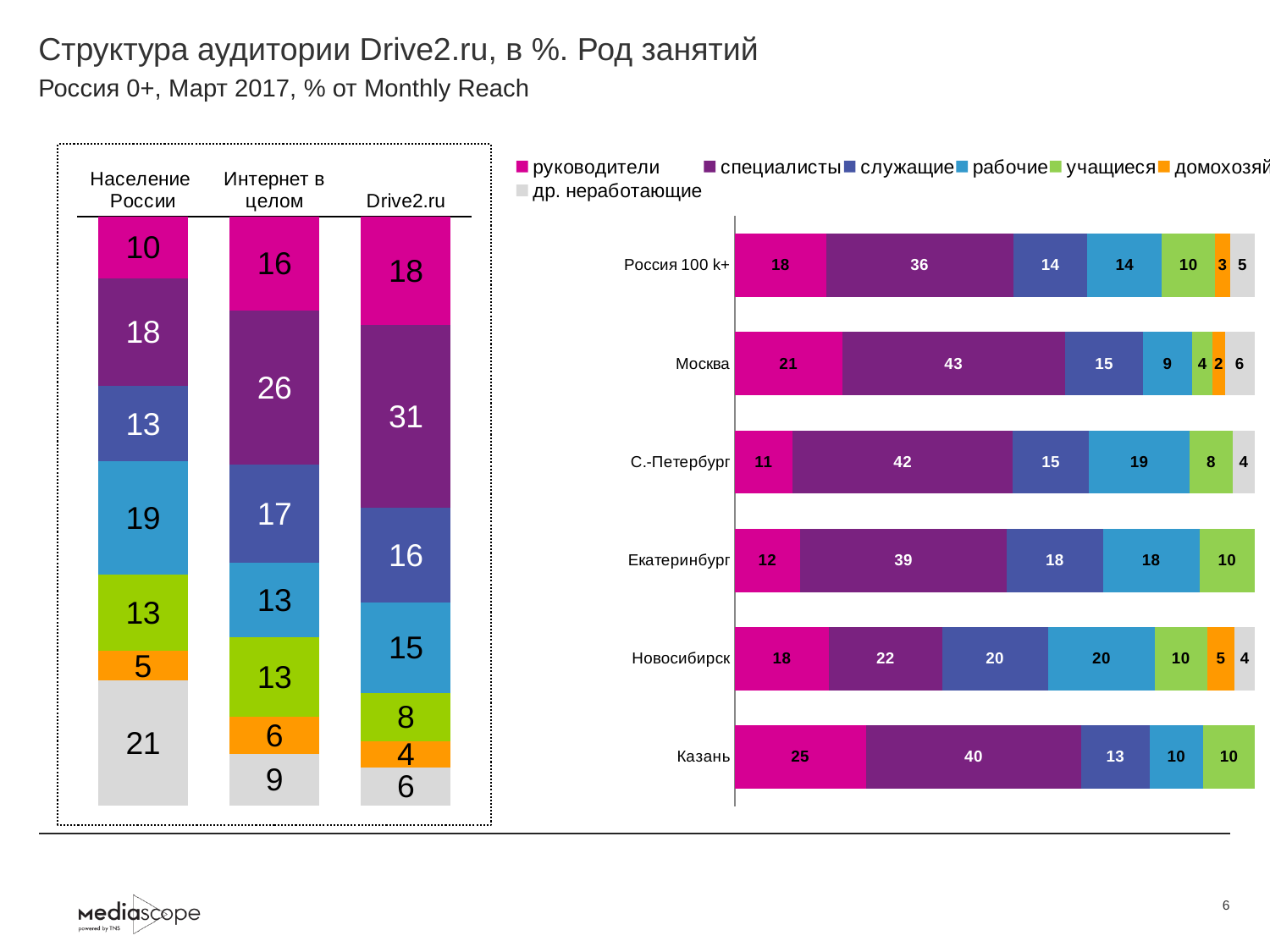
In the right chart, what is the value for руководители for Казань? 25 In the left chart, how many bars (columns) are shown? 3 In the left chart, what is the value for др. неработающие in the Интернет в целом bar? 9 In the right chart, which is larger: the рабочие value for С.-Петербург or for Москва? С.-Петербург In the left chart, what is the value for руководители in the Население России bar? 10 In the right chart, which city has the lowest value for руководители? С.-Петербург In the right chart, which city has the highest value for руководители? Казань In the right chart, what is the value for специалисты for Москва? 43 What type of chart is the right chart? Stacked bar chart In the left chart, what is the value for специалисты in the Drive2.ru bar? 31 In the right chart, how many cities/regions are listed on the vertical axis? 6 In the right chart, what is the difference between the специалисты values for Москва and Новосибирск? 21